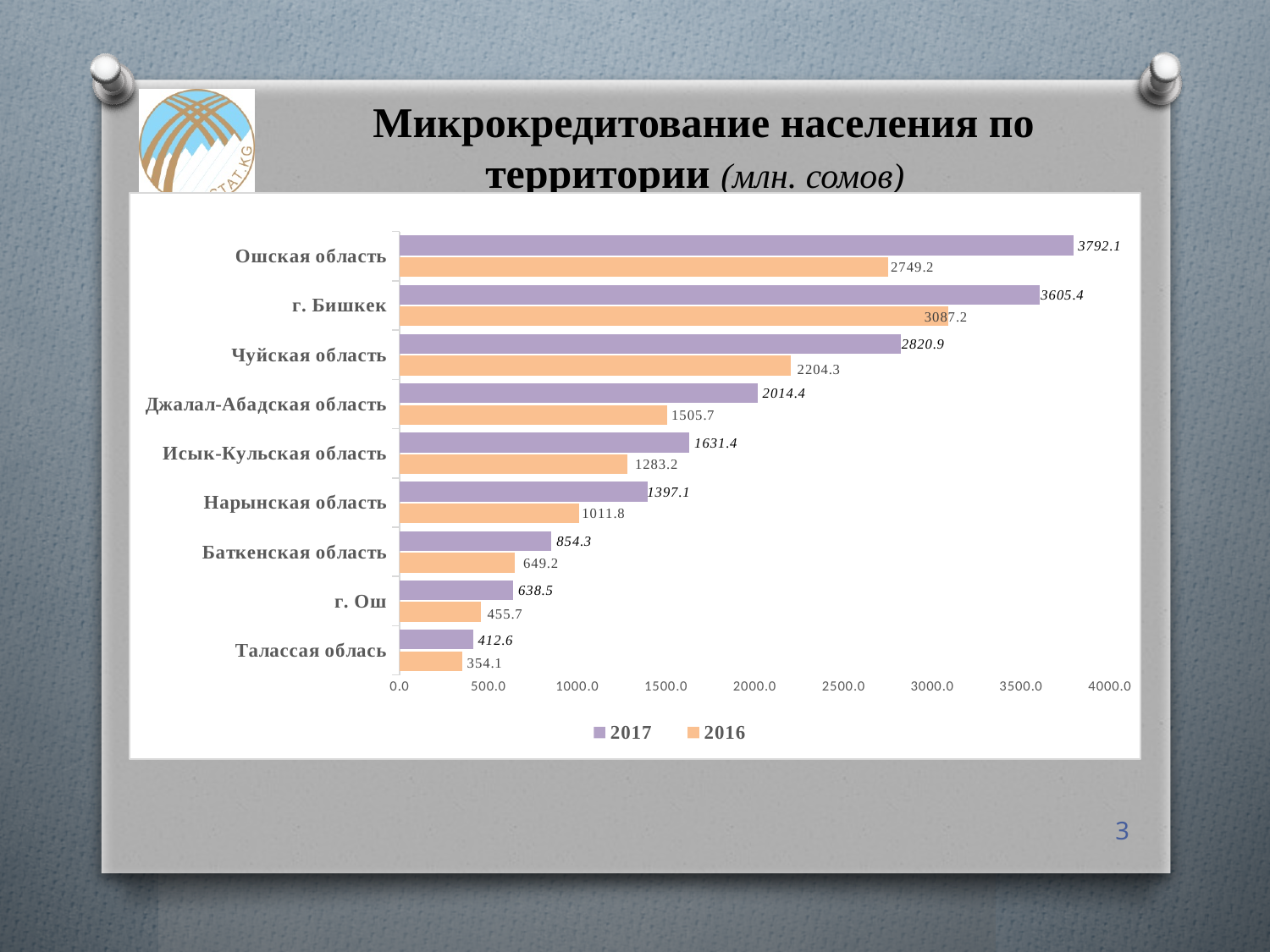
Which region has the lowest 2016 value? Талассая облась How many series does the legend list? 2 What is the 2016 value for г. Бишкек? 3087.2 What is the difference between the 2017 and 2016 values for Чуйская область? 616.6 What is the 2016 value for Нарынская область? 1011.8 What type of chart is shown on the slide? bar chart Which region has the highest 2017 value? Ошская область What is the 2017 value for Ошская область? 3792.1 Is the 2017 value for Джалал-Абадская область greater or less than 2000.0? greater Which is larger: the 2016 value for г. Бишкек or the 2016 value for Ошская область? г. Бишкек How many regions (categories) are shown on the chart? 9 What unit is given in the chart title? млн. сомов